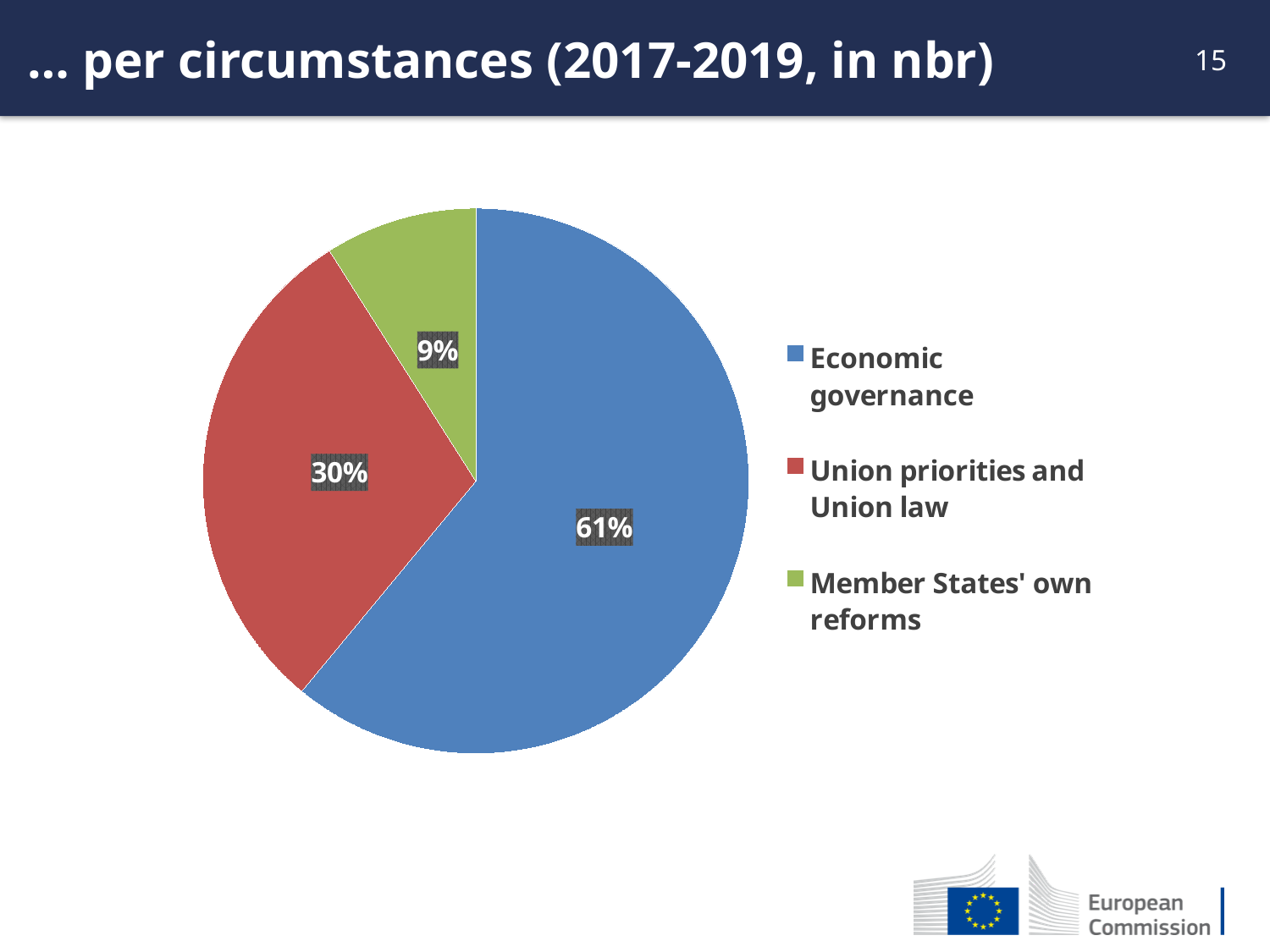
What is the difference in percentage points between Economic governance and Union priorities and Union law? 31 How many categories does the pie chart show? 3 What is the difference in percentage points between Union priorities and Union law and Member States' own reforms? 21 What share of the pie does Union priorities and Union law account for? 30% Which category has the largest slice of the pie? Economic governance What colour is the slice for Member States' own reforms? Green What is the title of the slide containing the pie chart? … per circumstances (2017-2019, in nbr) Which is larger, the share for Union priorities and Union law or the share for Member States' own reforms? Union priorities and Union law What kind of chart is shown on the slide? Pie chart What share of the pie does Member States' own reforms account for? 9% What share of the pie does Economic governance account for? 61% Which category has the smallest slice of the pie? Member States' own reforms